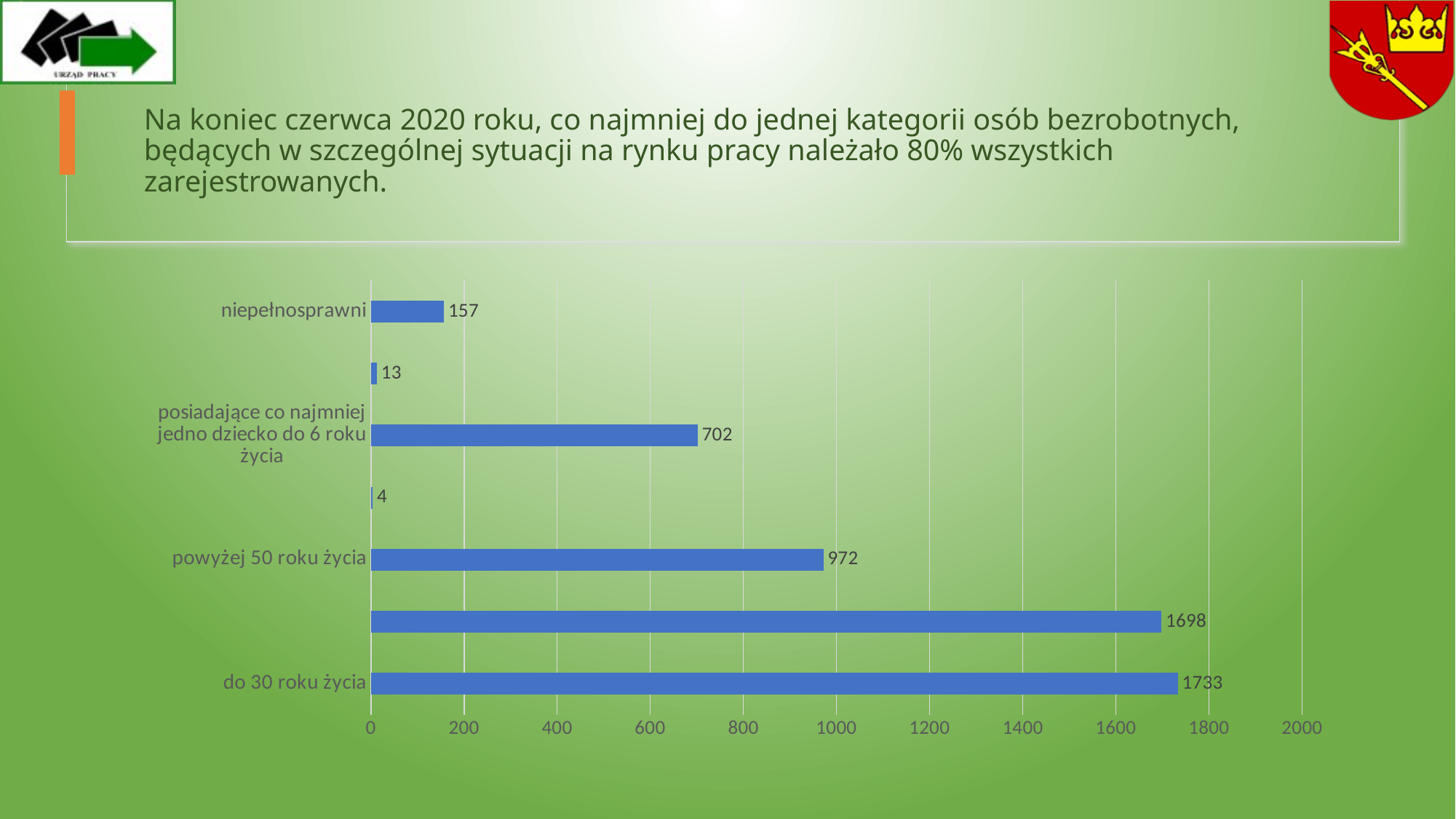
What is the difference between the values for 'powyżej 50 roku życia' and 'posiadające co najmniej jedno dziecko do 6 roku życia'? 270 What is the value for 'do 30 roku życia'? 1733 What is the smallest value shown on the chart? 4 What is the difference between the values for 'do 30 roku życia' and 'powyżej 50 roku życia'? 761 What is the value for 'posiadające co najmniej jedno dziecko do 6 roku życia'? 702 What kind of chart is shown on the slide? bar chart Which category has the highest value? do 30 roku życia Which is larger: the value for 'powyżej 50 roku życia' or for 'niepełnosprawni'? powyżej 50 roku życia What is the value for 'powyżej 50 roku życia'? 972 What is the value for 'niepełnosprawni'? 157 How many bars are shown on the chart? 7 Is the value for 'niepełnosprawni' greater or less than 200? less